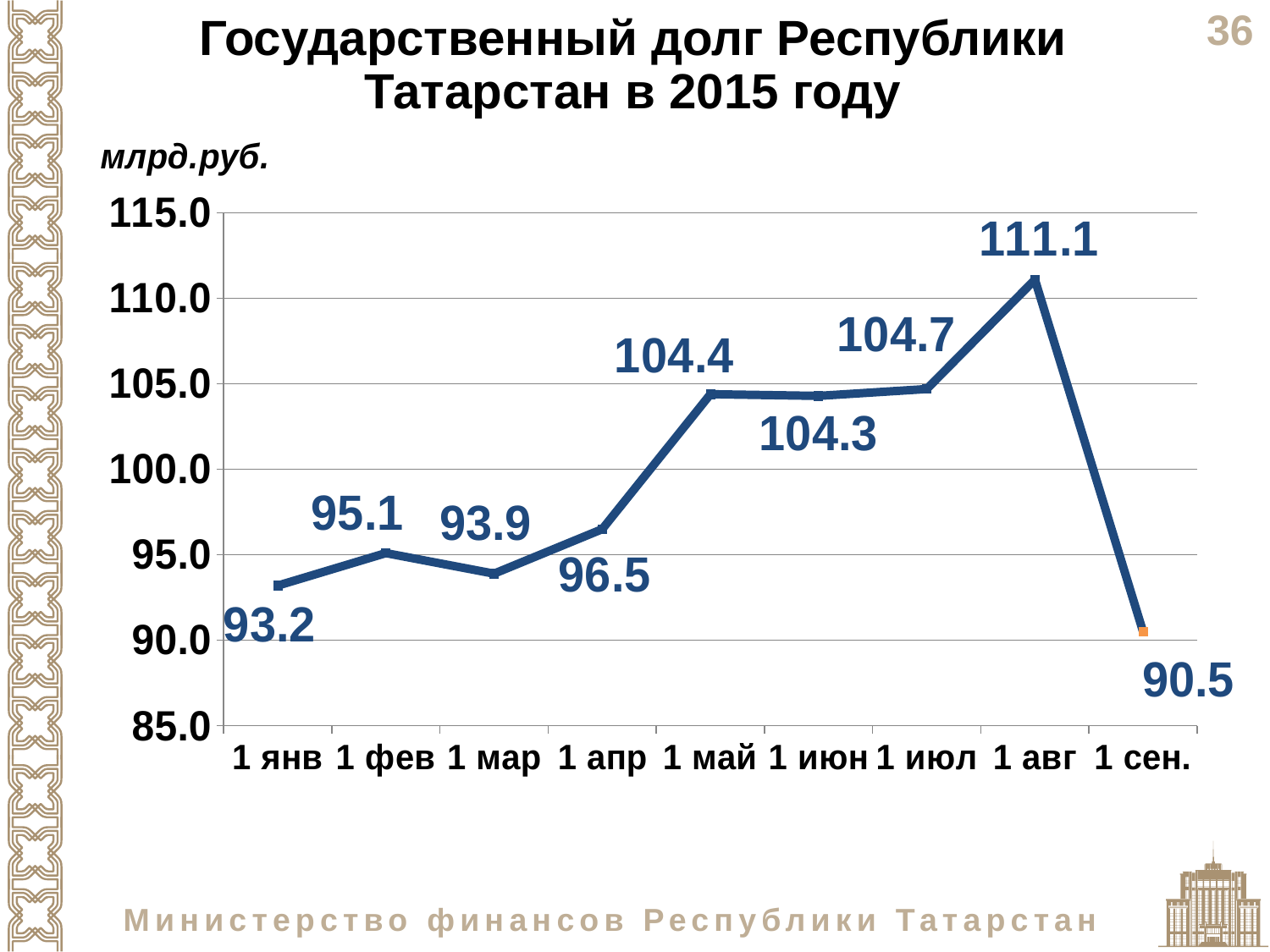
What is the difference between the values for 1 авг and 1 сен.? 20.6 How many data points are plotted on the chart? 9 Which date has the highest value? 1 авг What unit is shown above the chart's vertical axis? млрд.руб. What kind of chart is shown on the slide? line chart What is the value for 1 янв? 93.2 What is the value for 1 сен.? 90.5 Which is larger, the value for 1 фев or the value for 1 мар? 1 фев What is the value for 1 май? 104.4 What is the value for 1 авг? 111.1 Which date has the lowest value? 1 сен. What is the difference between the values for 1 май and 1 апр? 7.9